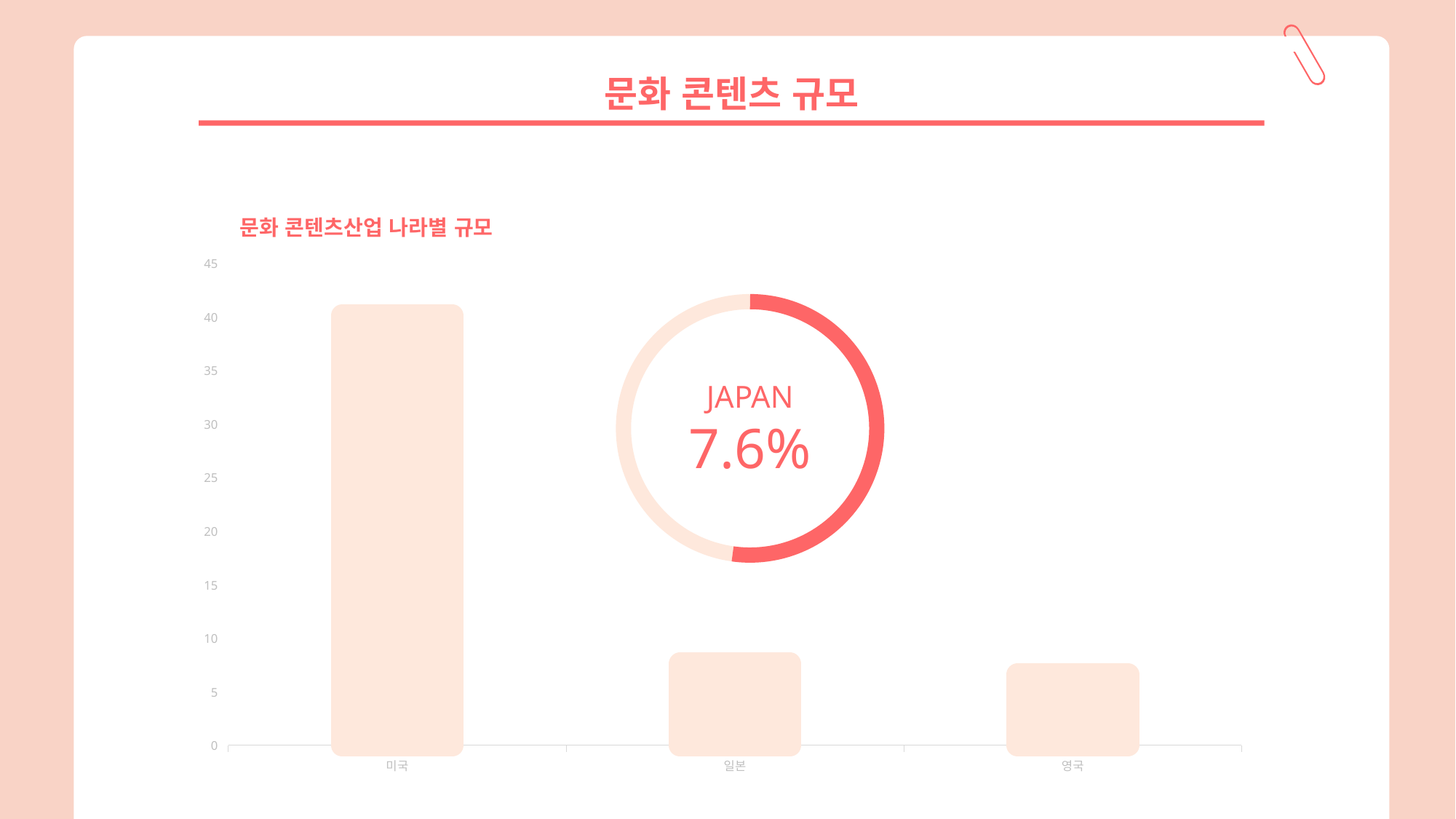
In the bar chart '문화 콘텐츠산업 나라별 규모', is the value for 일본 greater or less than 10? less In the bar chart '문화 콘텐츠산업 나라별 규모', which country has the highest value? 미국 In the bar chart '문화 콘텐츠산업 나라별 규모', which is larger, the value for 미국 or the value for 영국? 미국 Which country name is written inside the donut chart on the right of the slide? JAPAN In the bar chart '문화 콘텐츠산업 나라별 규모', is the value for 영국 greater or less than 5? greater What is the highest value shown on the vertical axis of the bar chart '문화 콘텐츠산업 나라별 규모'? 45 What percentage is shown in the centre of the donut chart on the right of the slide? 7.6% In the bar chart '문화 콘텐츠산업 나라별 규모', is the value for 미국 greater or less than 35? greater In the bar chart '문화 콘텐츠산업 나라별 규모', which is larger, the value for 미국 or the value for 일본? 미국 How many countries are shown in the bar chart '문화 콘텐츠산업 나라별 규모'? 3 What kind of chart is the chart titled '문화 콘텐츠산업 나라별 규모'? bar chart